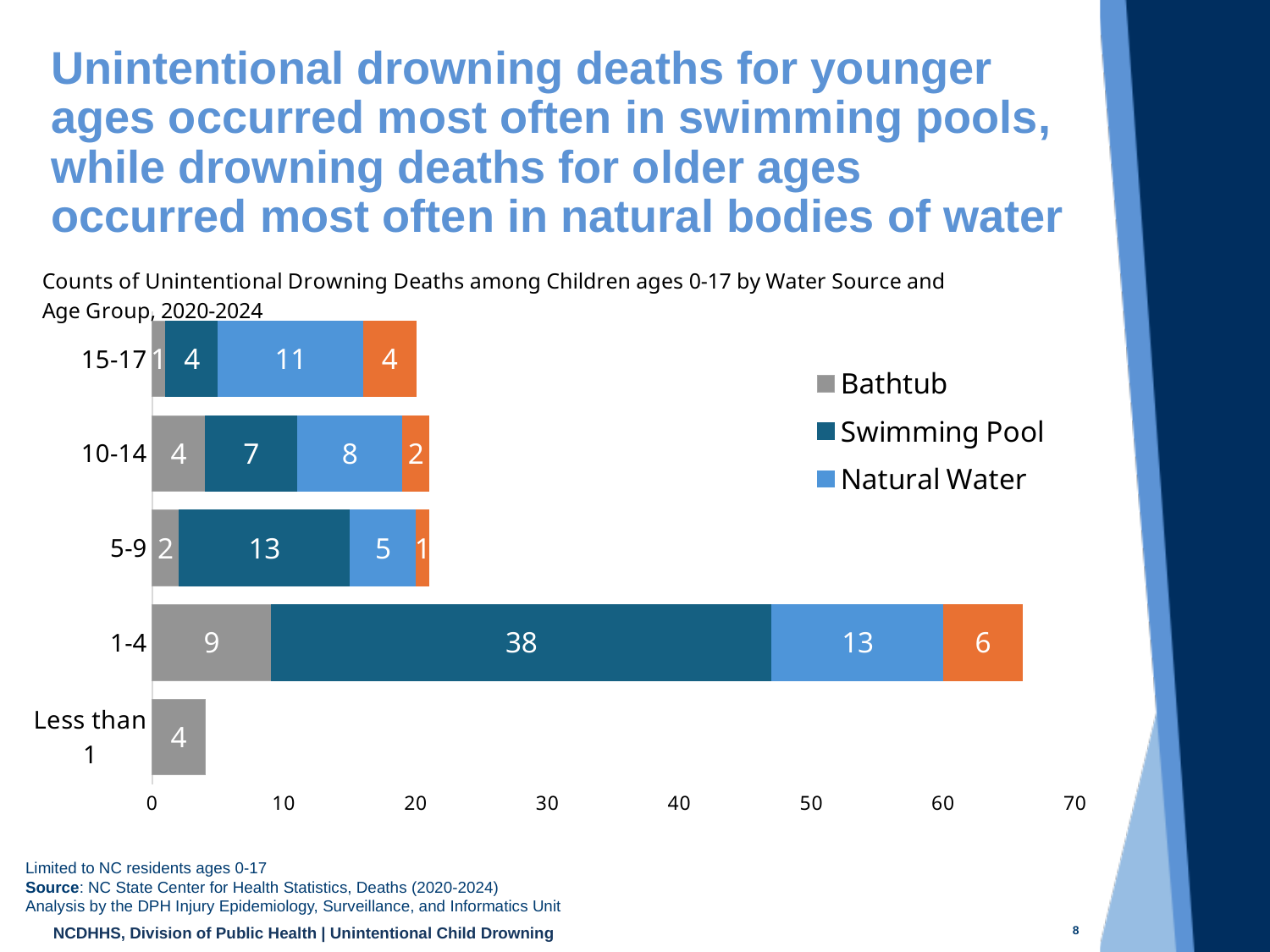
Which age group has the lowest total number of drowning deaths? Less than 1 Which is larger for the 10-14 age group, the Swimming Pool value or the Natural Water value? Natural Water Which age group has the highest total number of drowning deaths? 1-4 What is the difference between the Swimming Pool value for the 1-4 age group and the Swimming Pool value for the 5-9 age group? 25 What is the Natural Water value for the 15-17 age group? 11 What is the Swimming Pool value for the 5-9 age group? 13 What type of chart is shown on the slide? Stacked bar chart How many age groups are shown on the chart? 5 What is the Swimming Pool value for the 1-4 age group? 38 What is the Bathtub value for the Less than 1 age group? 4 What is the total number of drowning deaths for the 1-4 age group? 66 How many series does the legend list? 3